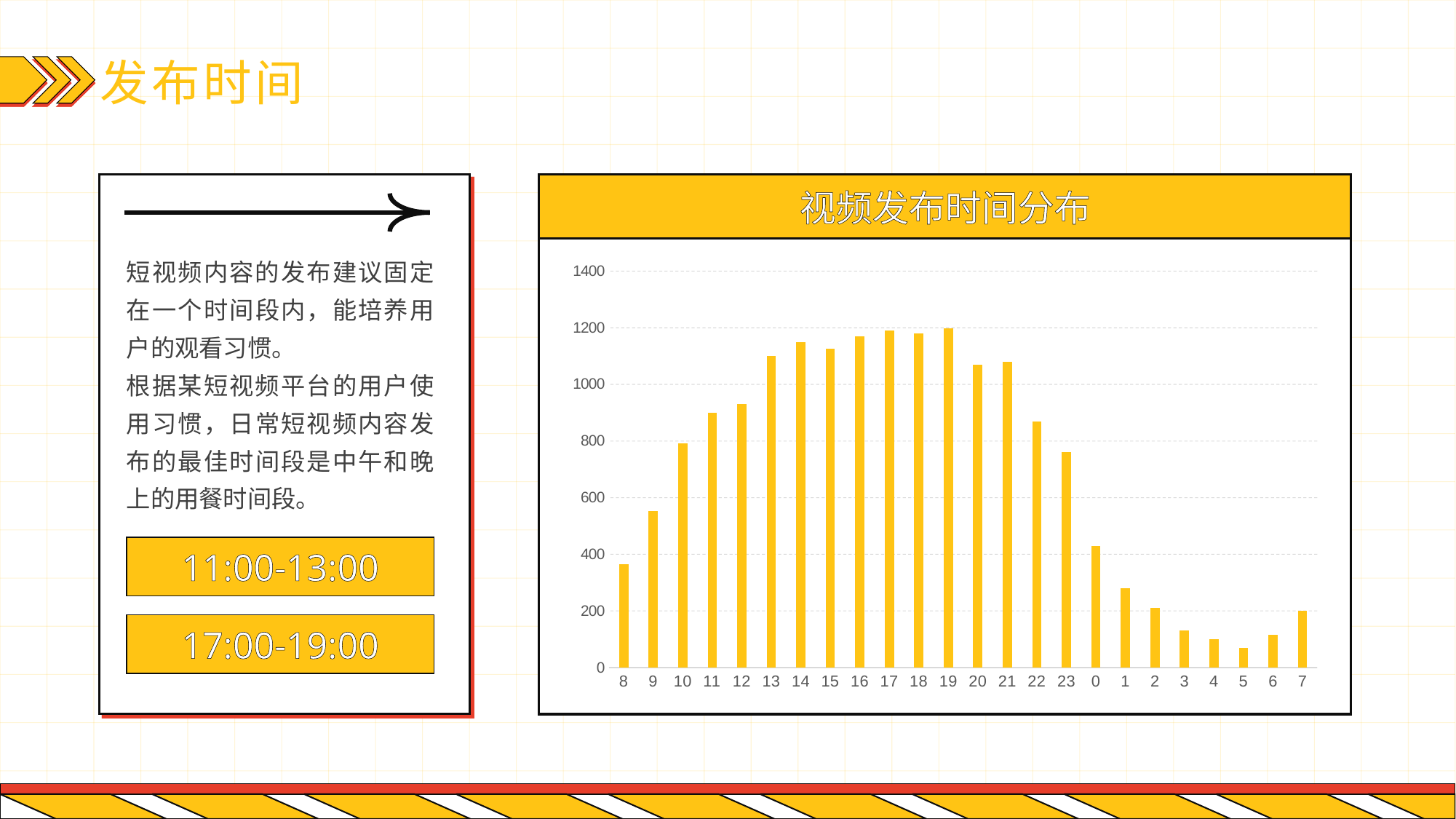
Is the value for hour 23 greater or less than 800? less Is the value for hour 1 greater or less than 400? less Do the values rise or fall from hour 8 to hour 13 along the x axis? rise Is the value for hour 13 greater or less than 1000? greater Which hour has the lowest bar in the chart? 5 Which has a higher value, hour 12 or hour 23? 12 Which has a higher value, hour 9 or hour 1? 9 How many hour categories are shown on the x axis of the chart? 24 What kind of chart is shown on the slide? bar chart What is the title of the chart? 视频发布时间分布